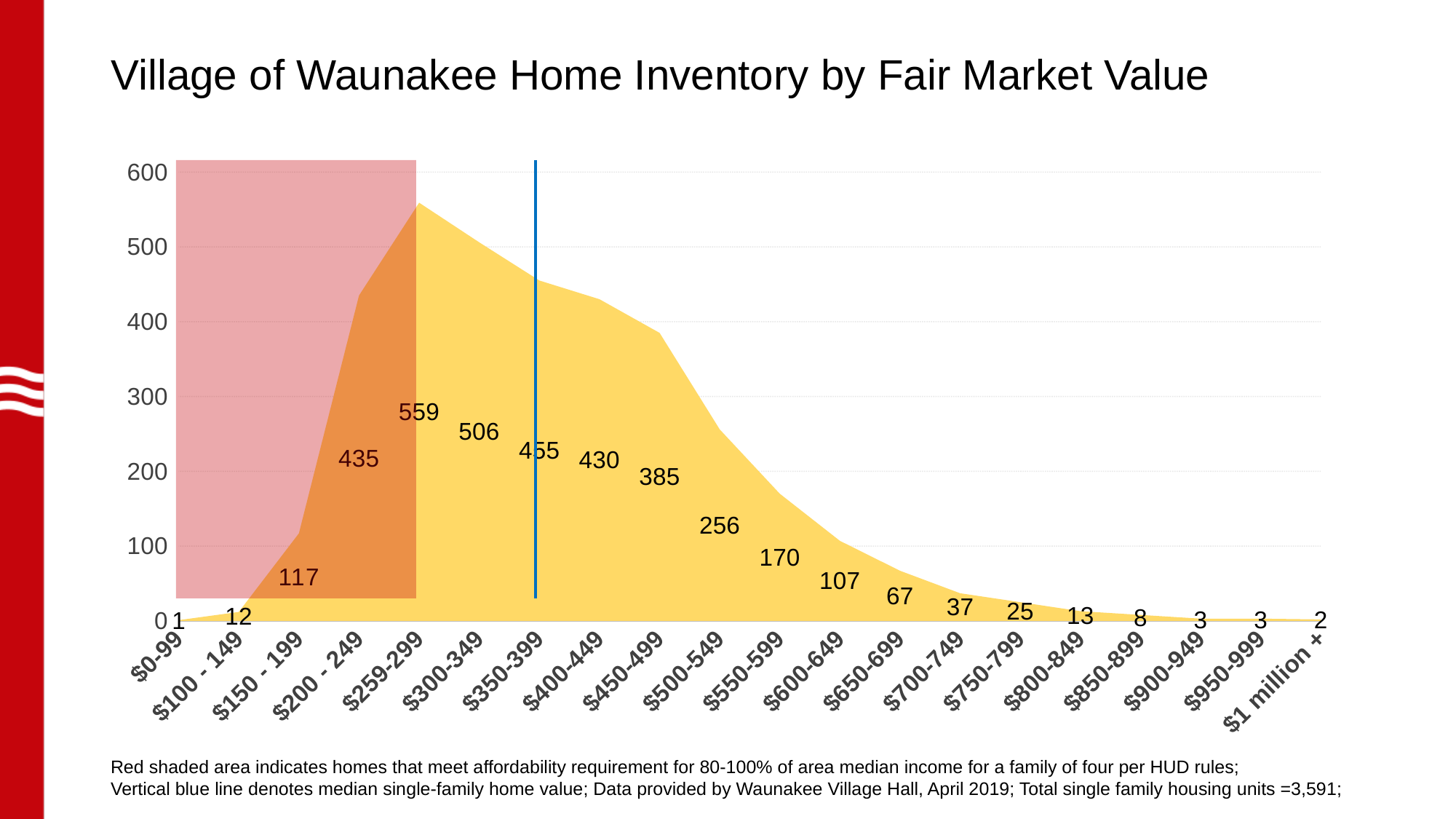
Which fair market value range has the highest number of homes? $259-299 What does the vertical blue line on the chart denote? Median single-family home value What is the value shown for the $1 million + category? 2 What is the number of homes in the $500-549 range? 256 Which has more homes, the $400-449 range or the $450-499 range? $400-449 What kind of chart is shown on the slide? Area chart Which fair market value range has the lowest number of homes? $0-99 What is the difference between the number of homes in the $259-299 range and the $300-349 range? 53 Is the value for the $350-399 range greater or less than 400? greater Do the values rise or fall along the x axis from the $259-299 range to the $1 million + range? Fall How many fair market value categories are shown on the x axis? 20 What is the number of homes in the $200 - 249 fair market value range? 435